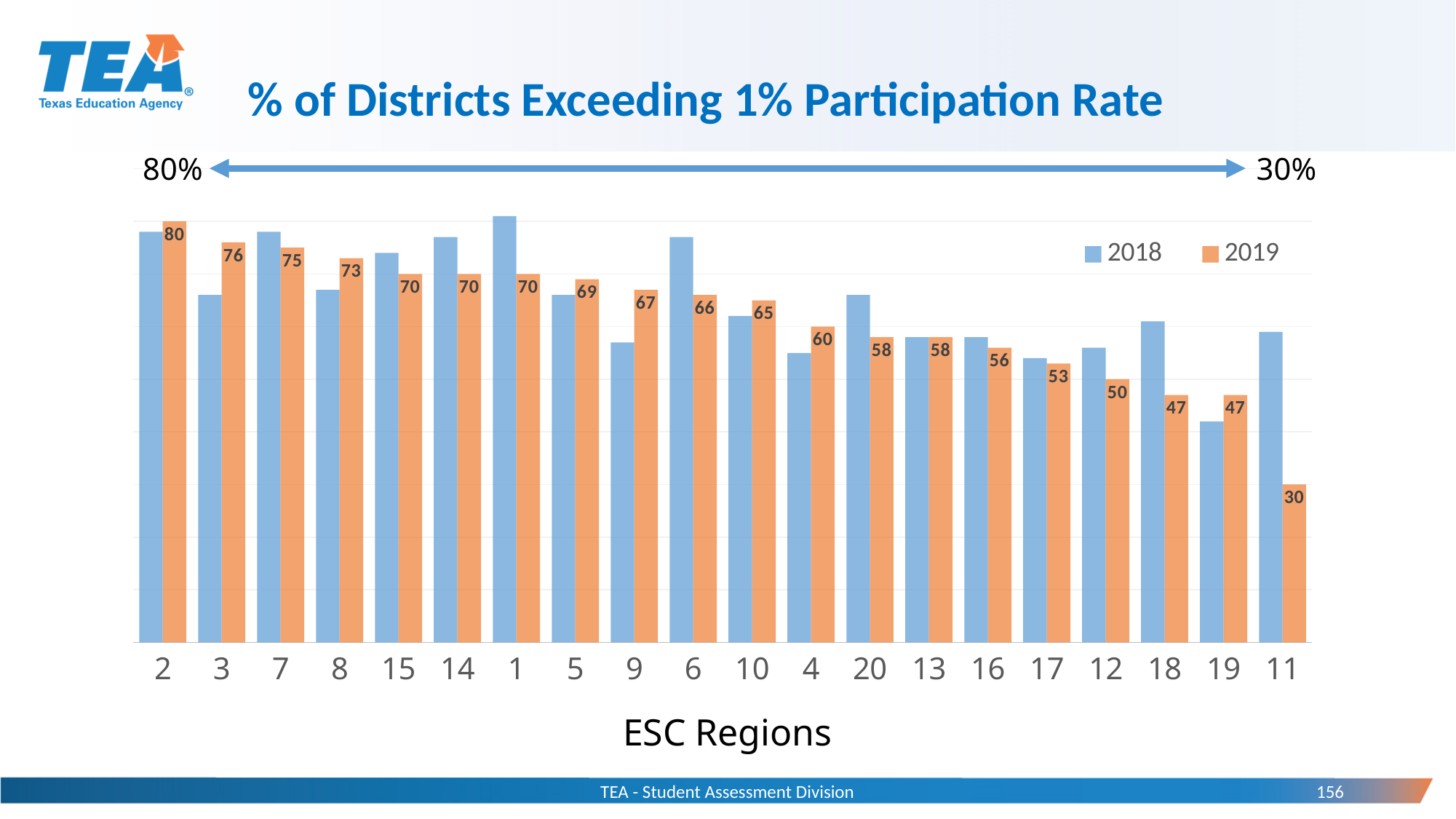
What is the difference between the 2019 values for ESC Region 4 and ESC Region 12? 10 What is the 2019 value for ESC Region 17? 53 For ESC Region 11, which series has the larger value, 2018 or 2019? 2018 What is the 2019 value for ESC Region 11? 30 Do the 2019 values generally rise or fall from left to right along the x axis? fall For ESC Region 9, which series has the larger value, 2018 or 2019? 2019 What is the difference between the 2019 values for ESC Region 2 and ESC Region 11? 50 How many series does the legend list? 2 Which ESC Region has the lowest 2019 value? 11 Which ESC Region has the highest 2019 value? 2 What is the 2019 value for ESC Region 2? 80 How many ESC Regions are shown on the x axis? 20